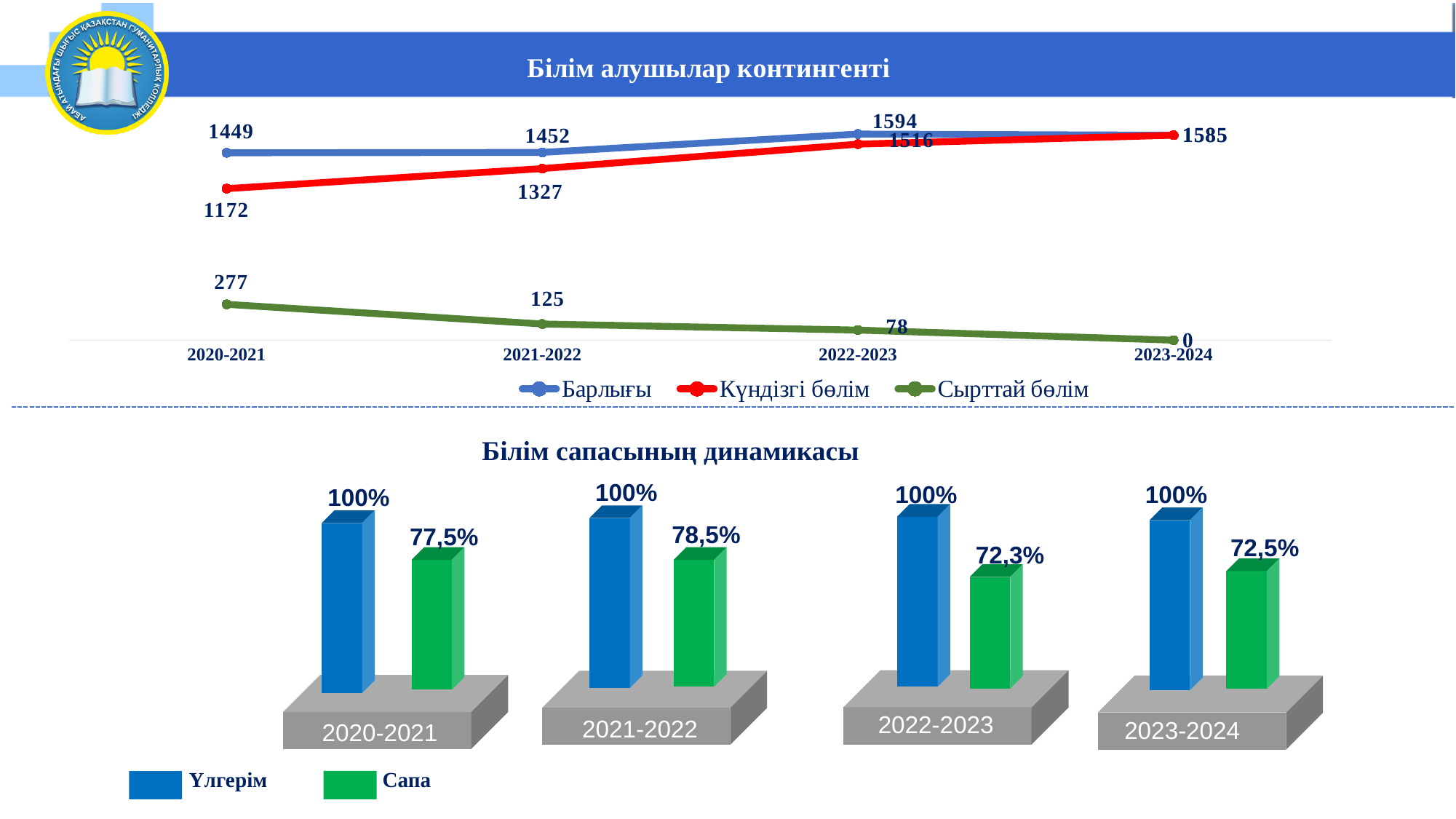
In the top chart 'Білім алушылар контингенті', in which period is Барлығы highest? 2022-2023 In the top chart 'Білім алушылар контингенті', what is the difference between Барлығы and Күндізгі бөлім in 2020-2021? 277 In the bottom chart 'Білім сапасының динамикасы', what is the value of Сапа for 2021-2022? 78,5% In the top chart 'Білім алушылар контингенті', what is the value of Күндізгі бөлім for 2021-2022? 1327 What kind of chart is the top chart 'Білім алушылар контингенті'? line chart How many series does the legend of the top chart 'Білім алушылар контингенті' list? 3 In the bottom chart 'Білім сапасының динамикасы', in which period is Сапа lowest? 2022-2023 In the top chart 'Білім алушылар контингенті', does Сырттай бөлім rise or fall from 2020-2021 to 2023-2024? fall In the top chart 'Білім алушылар контингенті', in which period is Сырттай бөлім lowest? 2023-2024 In the bottom chart 'Білім сапасының динамикасы', which is larger for 2023-2024: Үлгерім or Сапа? Үлгерім In the top chart 'Білім алушылар контингенті', what is the value of Сырттай бөлім for 2020-2021? 277 How many periods are shown on the x axis of the bottom chart 'Білім сапасының динамикасы'? 4